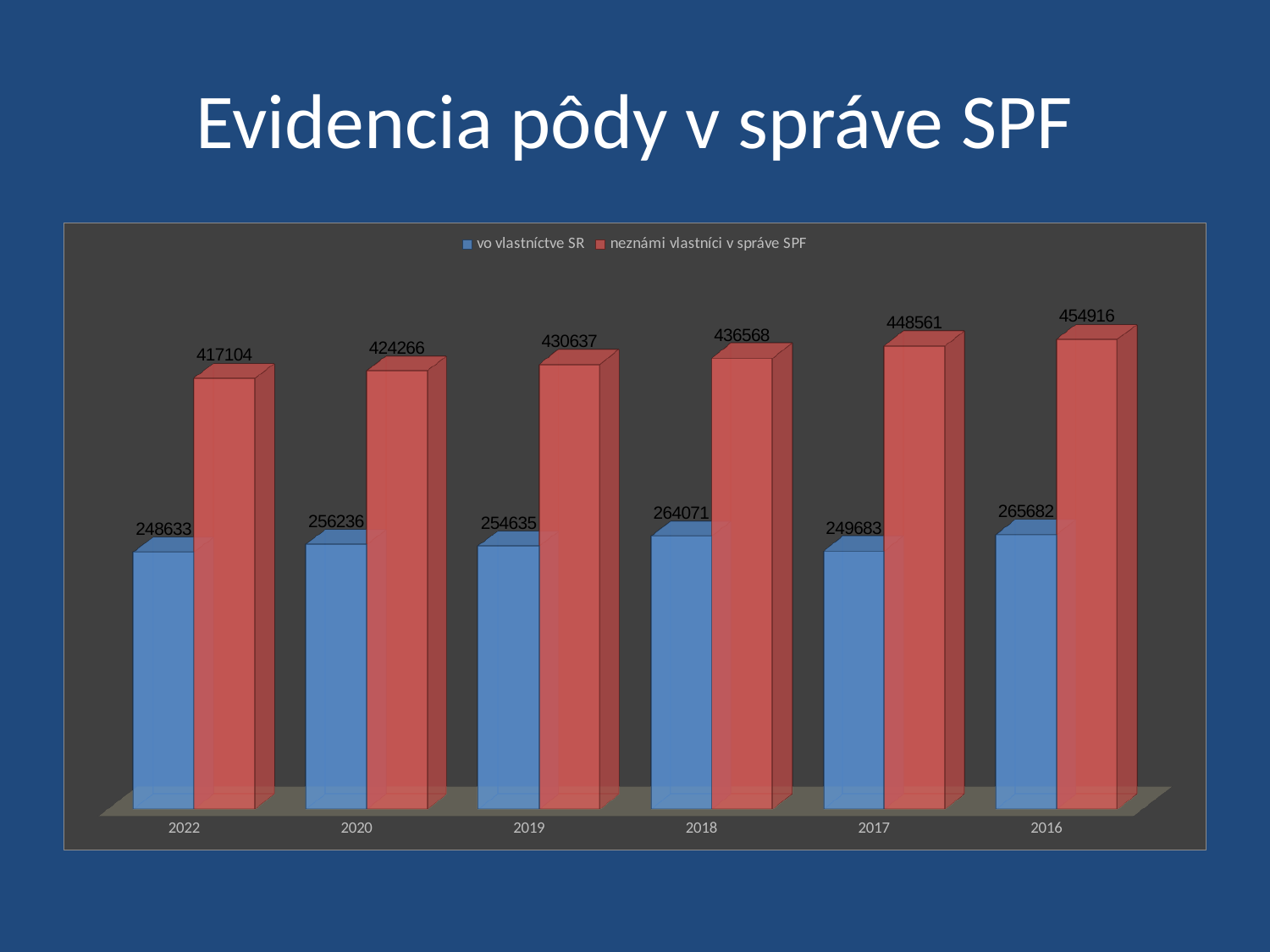
What is the value for 'neznámi vlastníci v správe SPF' in 2017? 448561 What is the value for 'vo vlastníctve SR' in 2018? 264071 How many series does the legend list? 2 Do the values for 'neznámi vlastníci v správe SPF' rise or fall from left to right along the x axis? rise What type of chart is shown on the slide? bar chart In which year is the value for 'vo vlastníctve SR' lowest? 2022 In which year is the value for 'neznámi vlastníci v správe SPF' highest? 2016 Which is larger in 2019: 'vo vlastníctve SR' or 'neznámi vlastníci v správe SPF'? neznámi vlastníci v správe SPF How many years are shown on the x axis? 6 What is the difference between the 'neznámi vlastníci v správe SPF' values for 2016 and 2022? 37812 What is the value for 'neznámi vlastníci v správe SPF' in 2022? 417104 What is the title of the slide? Evidencia pôdy v správe SPF